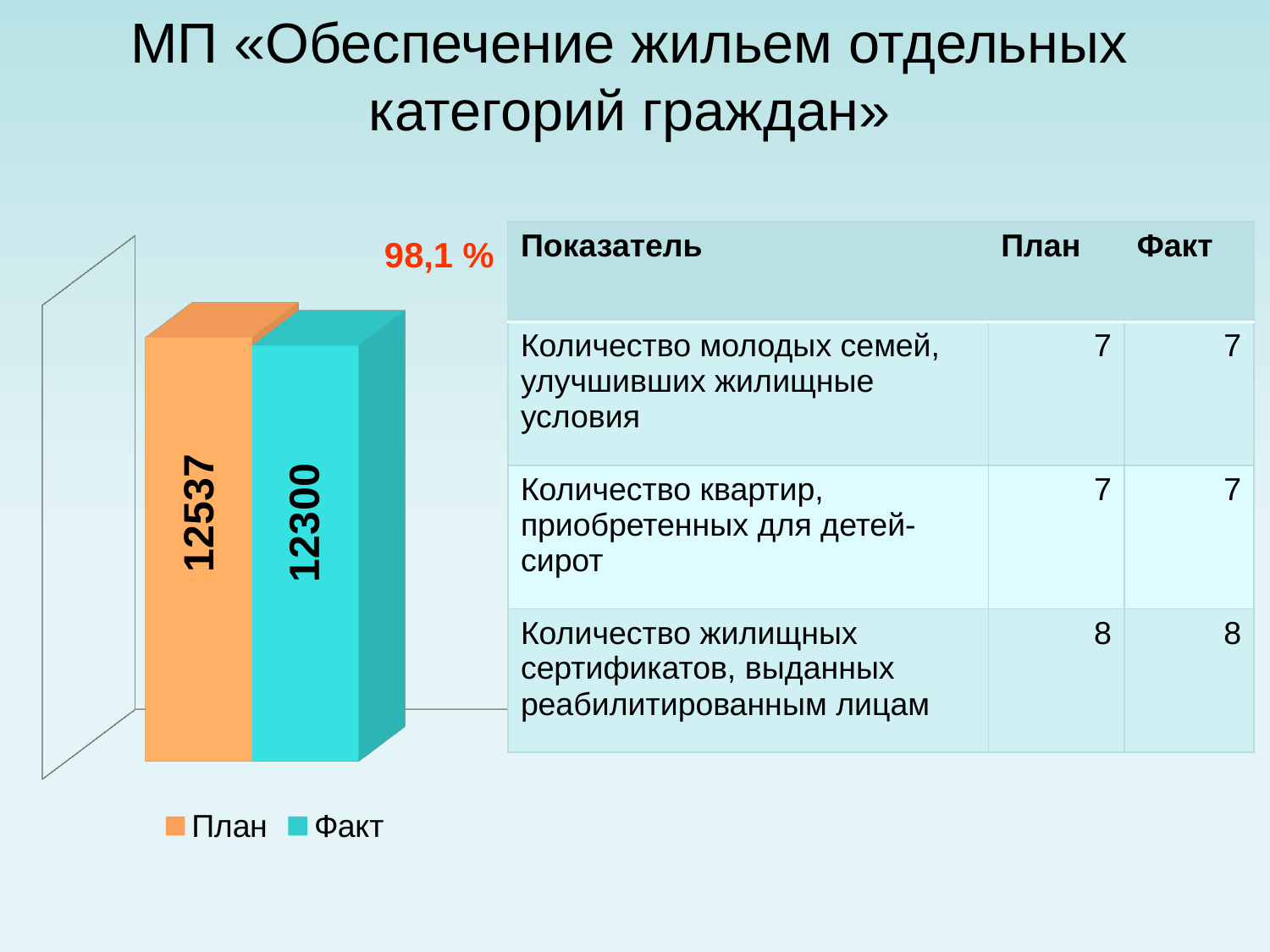
What is the difference between the План and Факт values in the chart? 237 Which bar in the chart is the highest? План What percentage is printed above the chart? 98,1 % How many series does the chart legend list? 2 What is the value of the Факт bar in the chart? 12300 What is the value of the План bar in the chart? 12537 How many bars are plotted in the chart? 2 What colour is the Факт bar in the chart? Turquoise What kind of chart is shown on the slide? Bar chart Which series has the higher value in the chart, План or Факт? План Which bar in the chart is the lowest? Факт